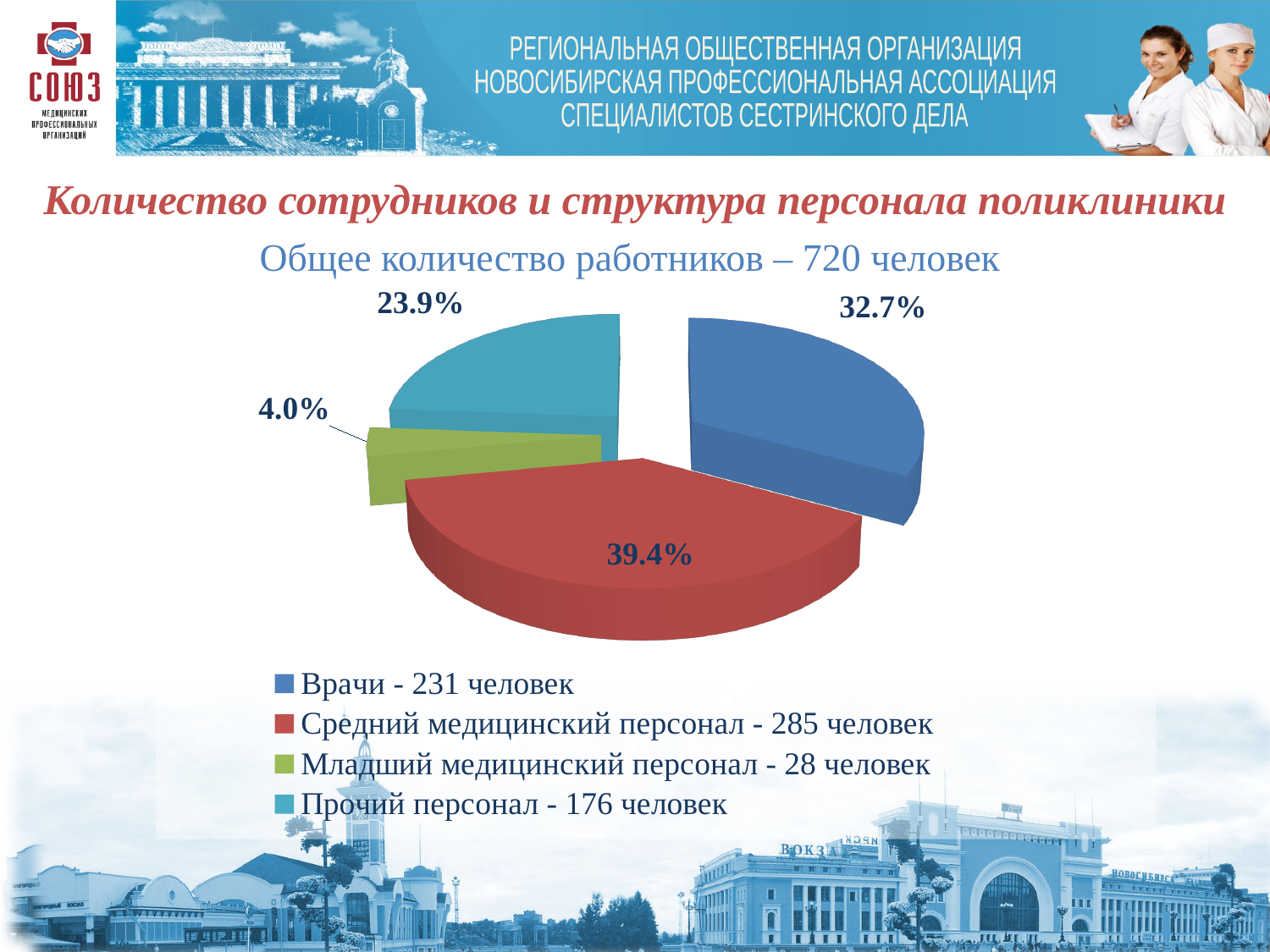
What kind of chart is shown on the slide? Pie chart Which category has the smallest share of the pie? Младший медицинский персонал Which has a larger share, Врачи or Прочий персонал? Врачи What percentage share does the slice for Младший медицинский персонал have? 4.0% What is the difference in percentage points between the shares of Средний медицинский персонал and Врачи? 6.7 According to the legend, how many people are in the Прочий персонал category? 176 человек What percentage share does the slice for Врачи have? 32.7% What percentage share does the slice for Прочий персонал have? 23.9% How many slices does the pie chart have? 4 What colour is the slice for Младший медицинский персонал? Green What percentage share does the slice for Средний медицинский персонал have? 39.4% Which category has the largest share of the pie? Средний медицинский персонал